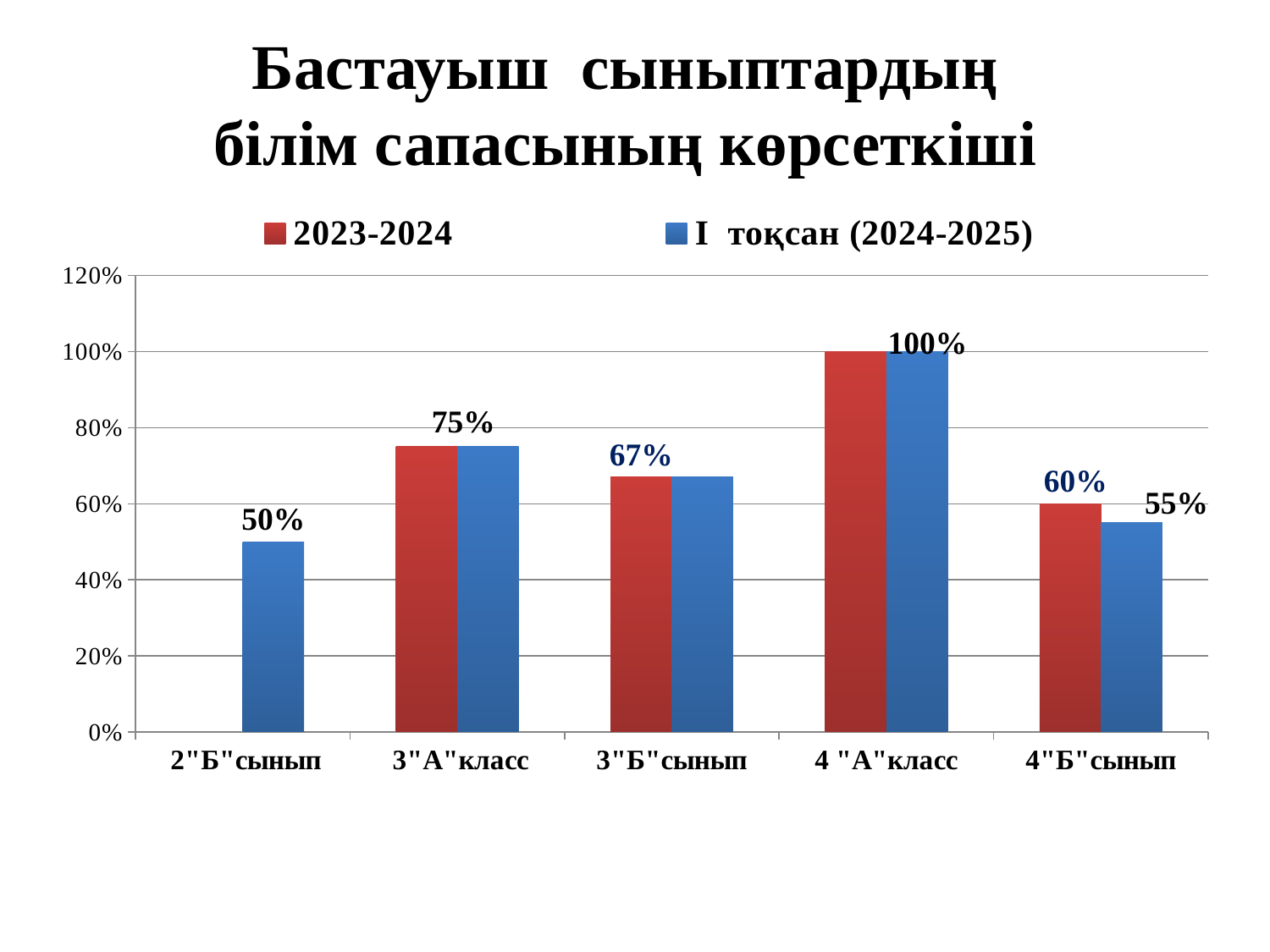
What is the difference between the 2023-2024 and I тоқсан (2024-2025) values for 4"Б"сынып? 5% What is the 2023-2024 value for 4"Б"сынып? 60% What value is labelled for 3"Б"сынып? 67% Is the 2023-2024 value for 3"А"класс greater or less than 60%? greater How many classes are shown on the x axis? 5 What value is labelled for 4 "А"класс? 100% What is the I тоқсан (2024-2025) value for 4"Б"сынып? 55% How many series does the legend list? 2 For 4"Б"сынып, which series has the larger value: 2023-2024 or I тоқсан (2024-2025)? 2023-2024 Which class has the highest values on the chart? 4 "А"класс What is the value for 2"Б"сынып in the I тоқсан (2024-2025) series? 50% Which class has the lowest value in the I тоқсан (2024-2025) series? 2"Б"сынып